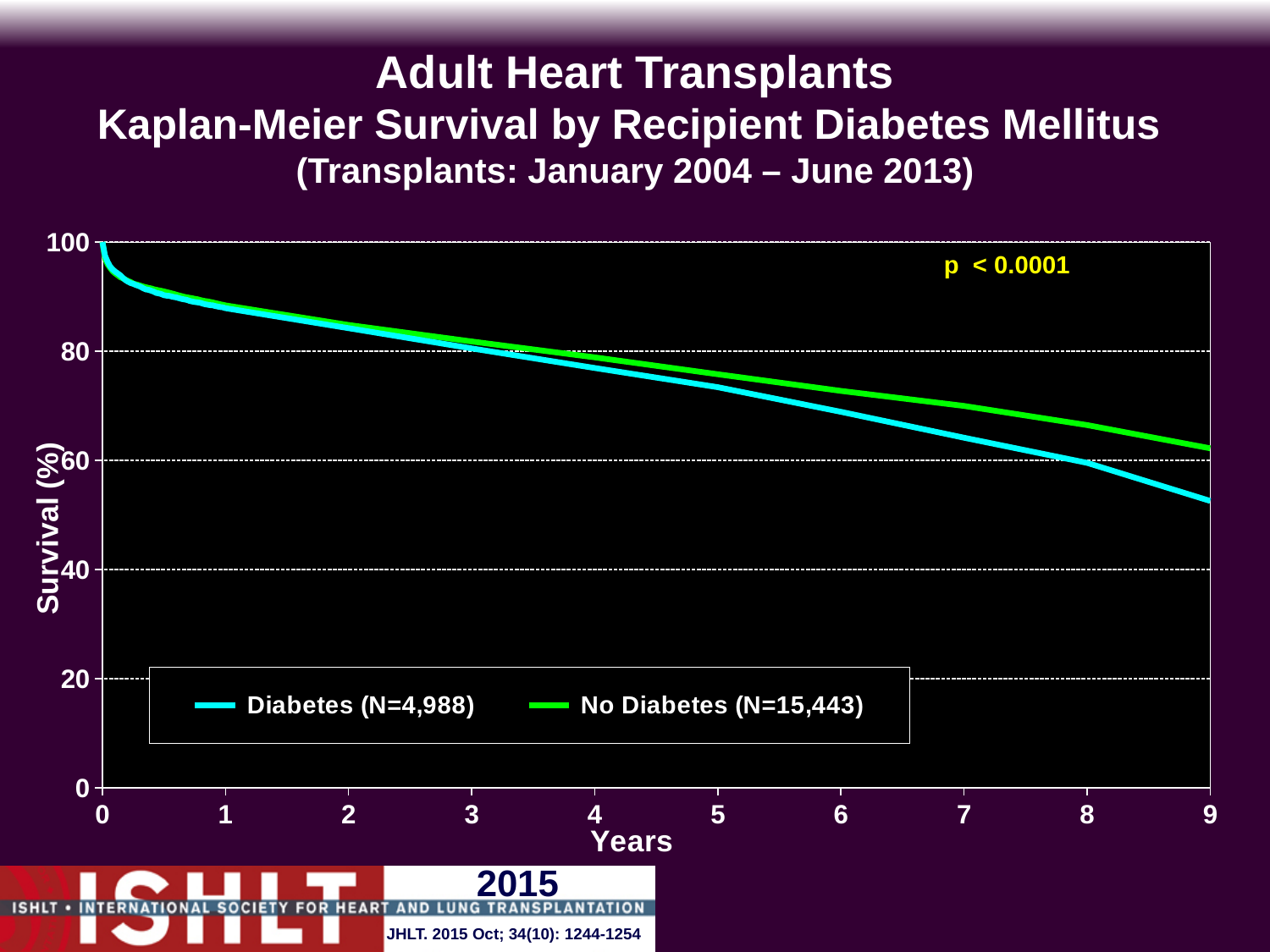
What kind of chart is shown on the slide? line chart Is the survival for the No Diabetes group at year 9 greater or less than 80? less At year 9, which group has the higher survival, Diabetes or No Diabetes? No Diabetes Is the survival for the Diabetes group at year 1 greater or less than 80? greater Is the survival for the No Diabetes group at year 7 greater or less than 60? greater Do the survival curves rise or fall as the years increase? fall What is the N for the Diabetes group shown in the legend? 4,988 What p-value is shown on the chart? p < 0.0001 How many series does the legend list? 2